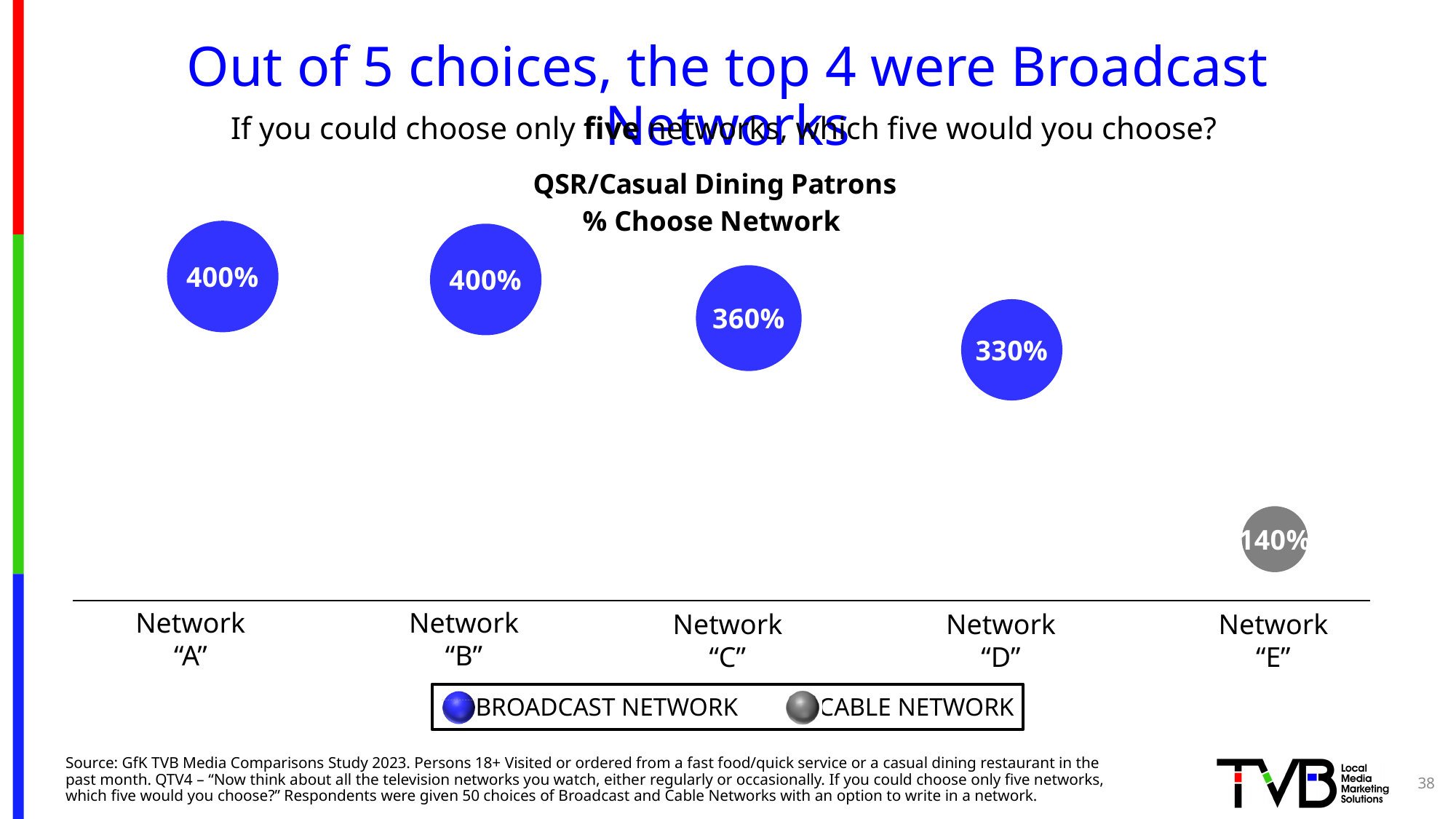
What is the value for Network "D"? 330% What is the value for Network "E"? 140% What is the difference between the values for Network "C" and Network "D"? 30% Which has a larger value, Network "C" or Network "D"? Network "C" Which legend entry does the gray bubble for Network "E" belong to? CABLE NETWORK How many networks are plotted on the chart? 5 What is the difference between the values for Network "A" and Network "E"? 260% Do the values rise or fall from Network "A" to Network "E"? fall Which network has the lowest value? Network "E" How many series does the legend list? 2 What is the value for Network "A"? 400% What is the value for Network "C"? 360%